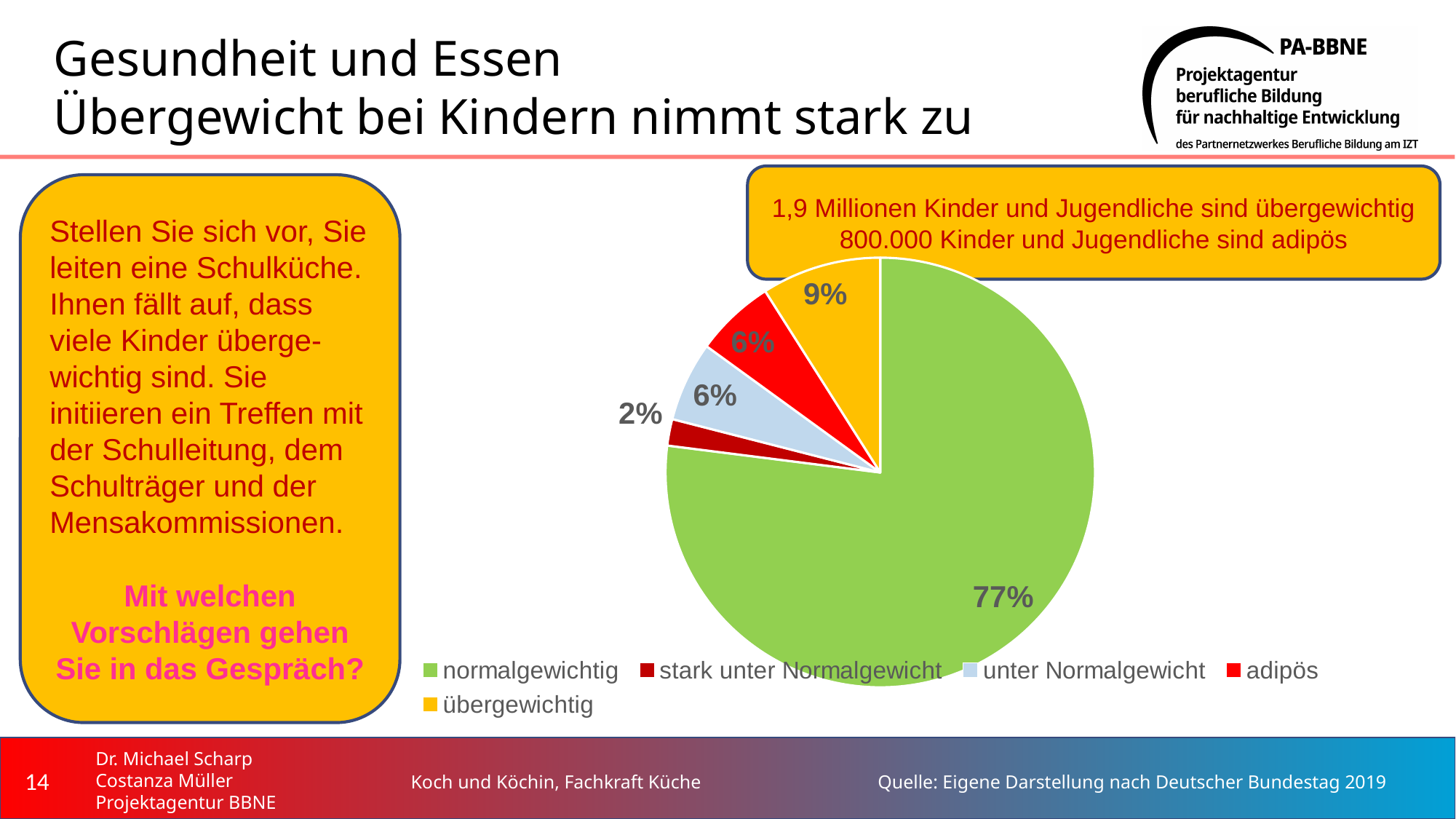
Which is larger in the pie chart, 'übergewichtig' or 'adipös'? übergewichtig Which category has the smallest slice in the pie chart? stark unter Normalgewicht How many slices does the pie chart have? 5 Which category has the largest slice in the pie chart? normalgewichtig What is the difference in percentage points between 'normalgewichtig' and 'übergewichtig' in the pie chart? 68 What kind of chart is shown on the slide? pie chart What is the value shown for 'adipös' in the pie chart? 6% What is the value shown for 'unter Normalgewicht' in the pie chart? 6% What is the value shown for 'übergewichtig' in the pie chart? 9% What share of the pie chart is labelled 'normalgewichtig'? 77% How many entries does the legend of the pie chart list? 5 What is the value shown for 'stark unter Normalgewicht' in the pie chart? 2%